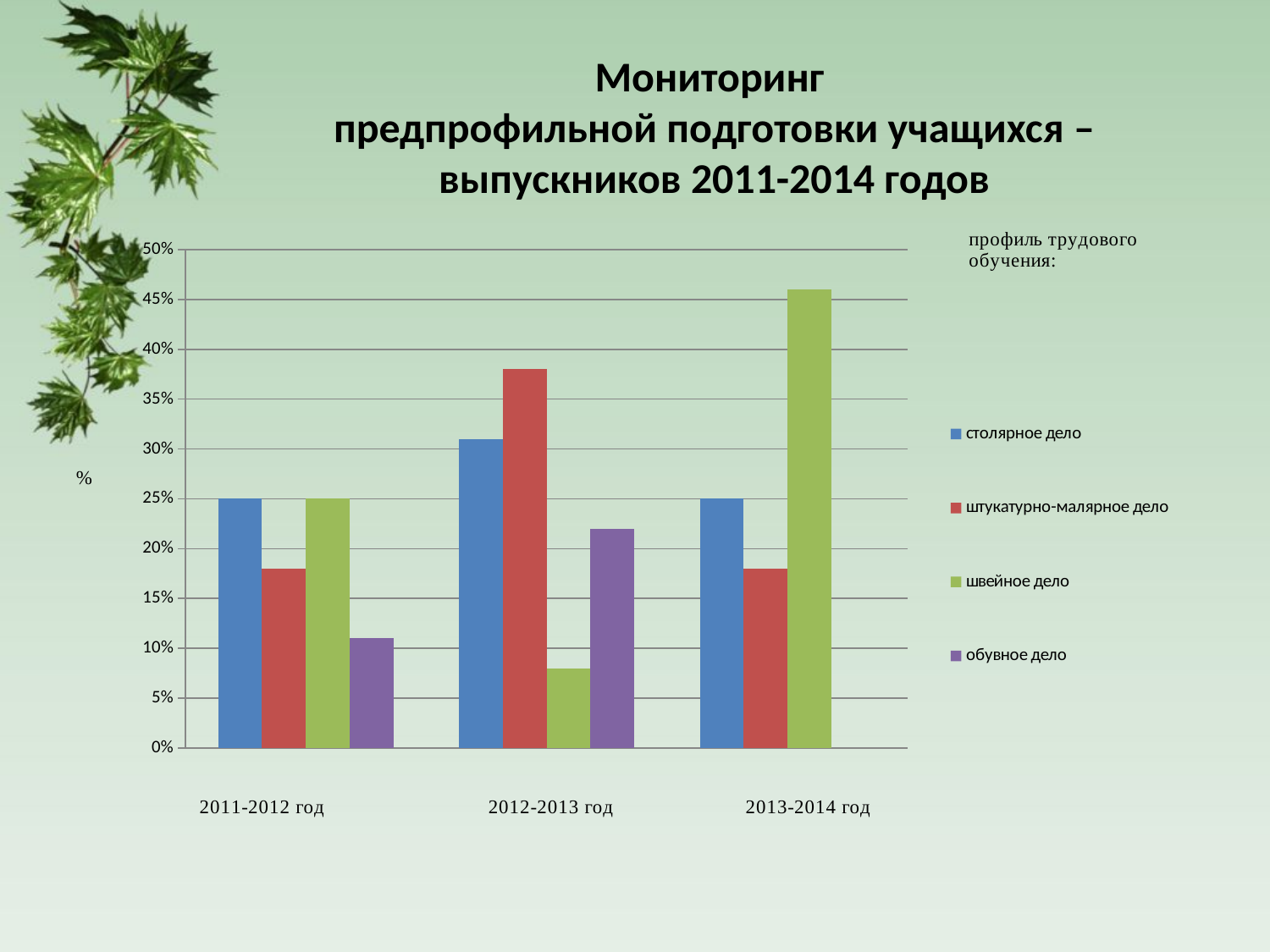
Does the value for швейное дело rise or fall from 2012-2013 год to 2013-2014 год? rise Is the value for обувное дело in 2011-2012 год greater or less than 15%? less What is the value for столярное дело in 2011-2012 год? 25% Is the value for штукатурно-малярное дело in 2012-2013 год greater or less than 35%? greater How many year groups are shown on the x axis? 3 Which series has the highest value in the 2013-2014 год group? швейное дело Which series has the lowest value in the 2012-2013 год group? швейное дело In the 2012-2013 год group, which is larger: столярное дело or штукатурно-малярное дело? штукатурно-малярное дело What heading is shown above the legend? профиль трудового обучения: How many series does the legend list? 4 What kind of chart is shown on the slide? bar chart How many bars are plotted for the 2013-2014 год group? 3